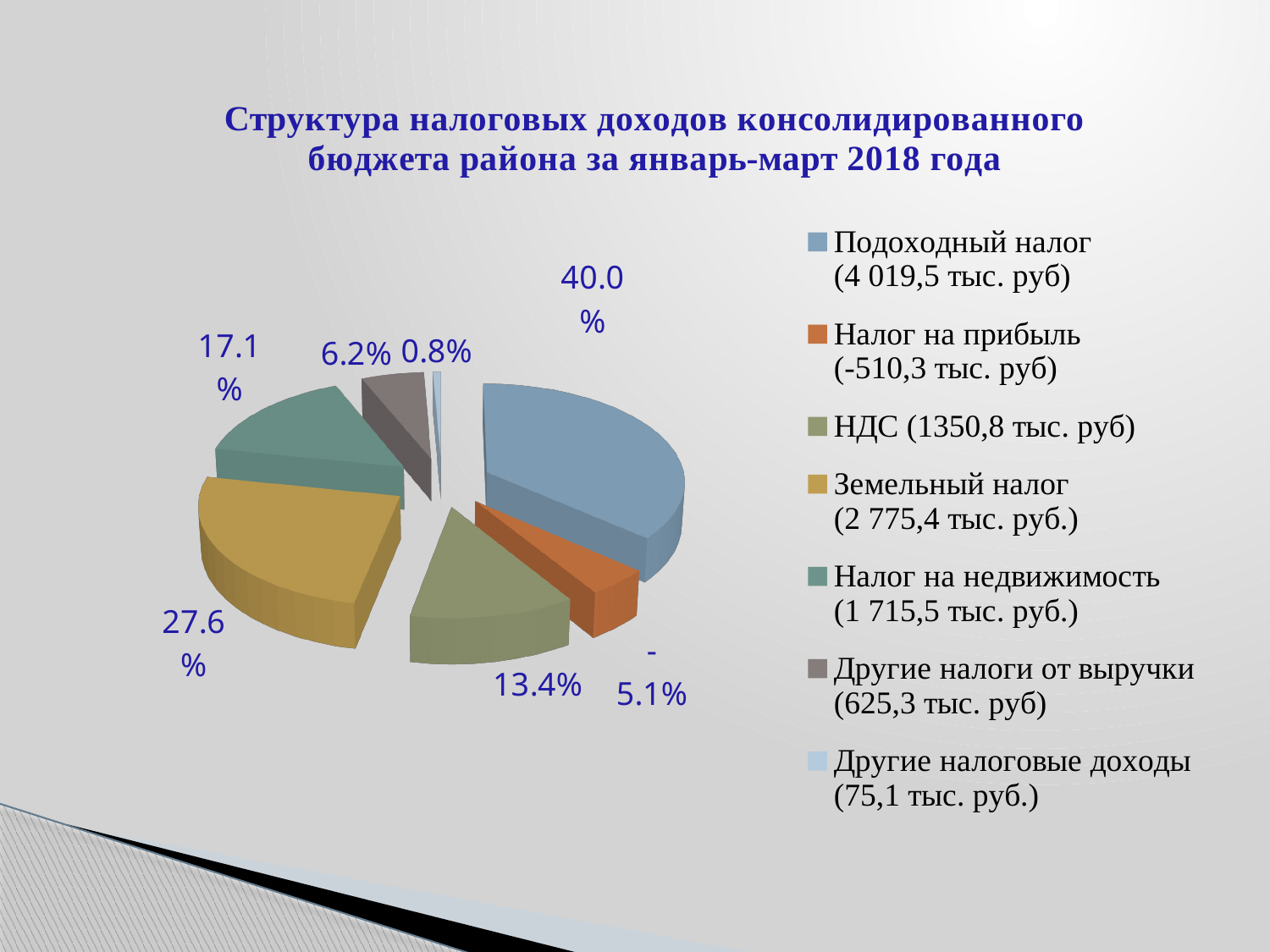
What percentage share is shown for Земельный налог? 27.6% What percentage share is shown for НДС? 13.4% Which category has the smallest share of the pie? Налог на прибыль Which category has the largest share of the pie? Подоходный налог How many categories does the legend list? 7 What percentage share is shown for Подоходный налог? 40.0% What is the difference in percentage points between the shares of Земельный налог and Налог на недвижимость? 10.5 What kind of chart is shown on the slide? pie chart What percentage share is shown for Налог на недвижимость? 17.1% What percentage share is shown for Налог на прибыль? -5.1% What amount in thousand rubles does the legend give for НДС? 1350,8 тыс. руб What percentage share is shown for Другие налоговые доходы? 0.8%